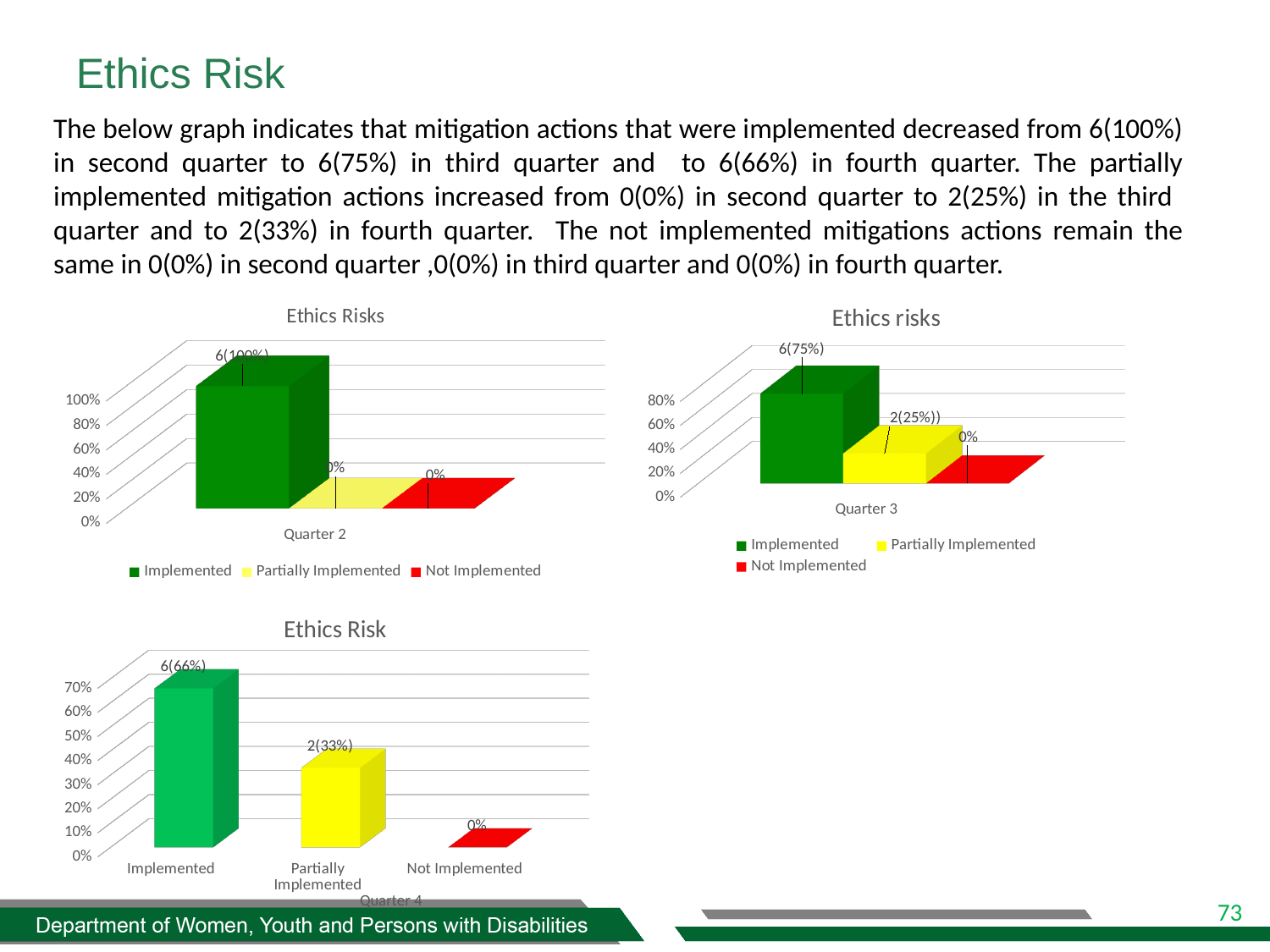
In the top-right chart (Quarter 3), what is the data label on the Partially Implemented bar? 2(25%)) How many series does the legend of the top-left chart (Quarter 2) list? 3 In the bottom-left chart (Quarter 4), what is the data label on the Partially Implemented bar? 2(33%) In the top-left chart (Quarter 2), what is the data label on the Implemented bar? 6(100%) In the top-right chart (Quarter 3), what is the data label on the Implemented bar? 6(75%) In the bottom-left chart (Quarter 4), is the value for Partially Implemented greater or less than 40%? less What kind of chart is the bottom-left chart (Quarter 4)? Bar chart In the bottom-left chart (Quarter 4), which category has the highest value? Implemented In the top-right chart (Quarter 3), which is larger, Implemented or Partially Implemented? Implemented In the bottom-left chart (Quarter 4), what is the data label on the Not Implemented bar? 0% In the top-right chart (Quarter 3), which category has the lowest value? Not Implemented In the bottom-left chart (Quarter 4), what is the data label on the Implemented bar? 6(66%)